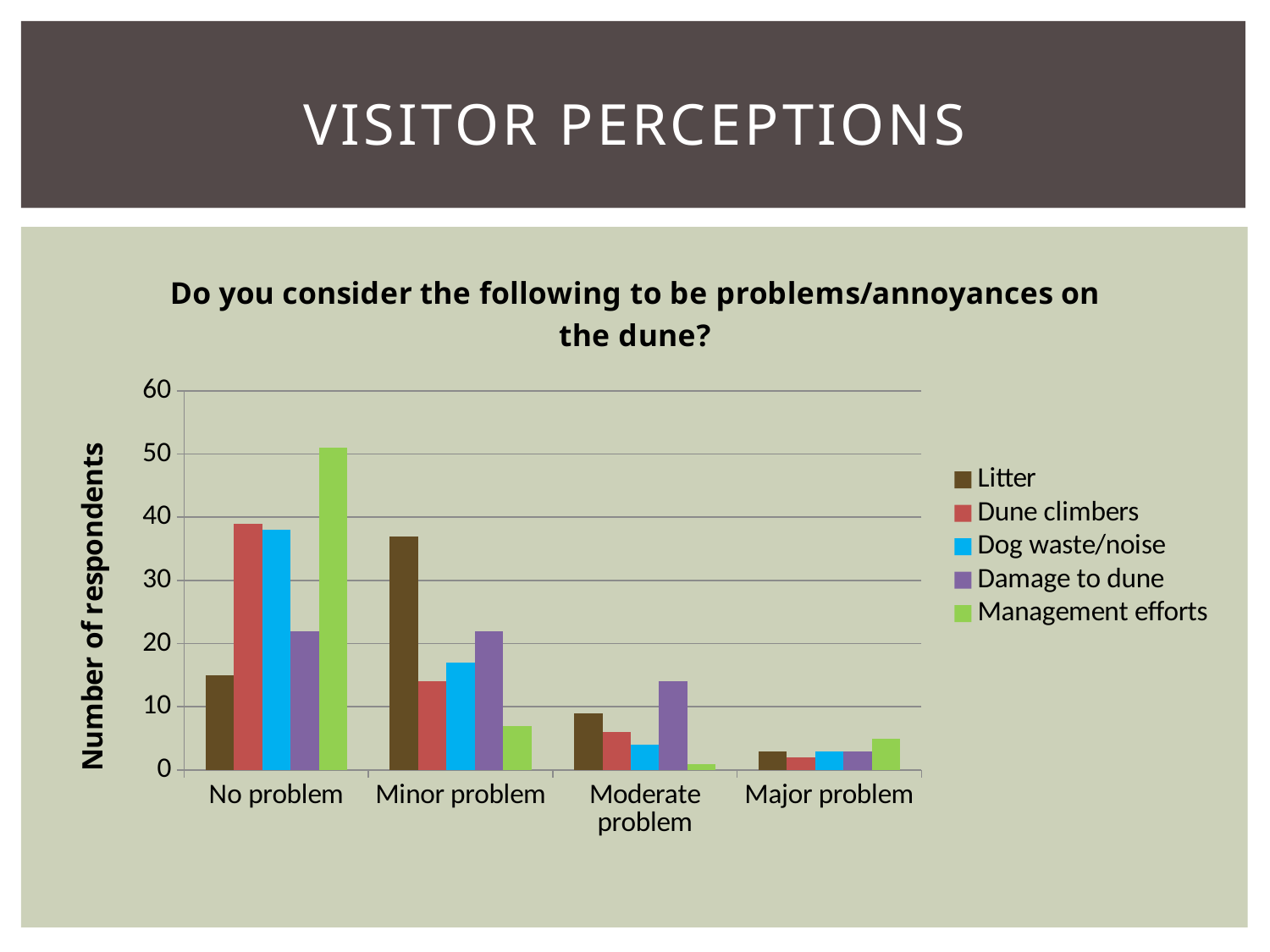
Is the value for Litter in the 'Minor problem' category greater or less than 30? greater How many response categories are shown on the x axis? 4 Which series has the highest value in the 'Moderate problem' category? Damage to dune What kind of chart is shown on the slide? bar chart Is the value for Management efforts in the 'No problem' category greater or less than 40? greater What is the title of the vertical axis? Number of respondents Which series has the highest value in the 'Minor problem' category? Litter Do the values for Dune climbers rise or fall from 'No problem' to 'Major problem'? fall Which series has the lowest value in the 'No problem' category? Litter In the 'Moderate problem' category, which is larger: Damage to dune or Dog waste/noise? Damage to dune Which series has the highest value in the 'No problem' category? Management efforts How many series does the legend list? 5